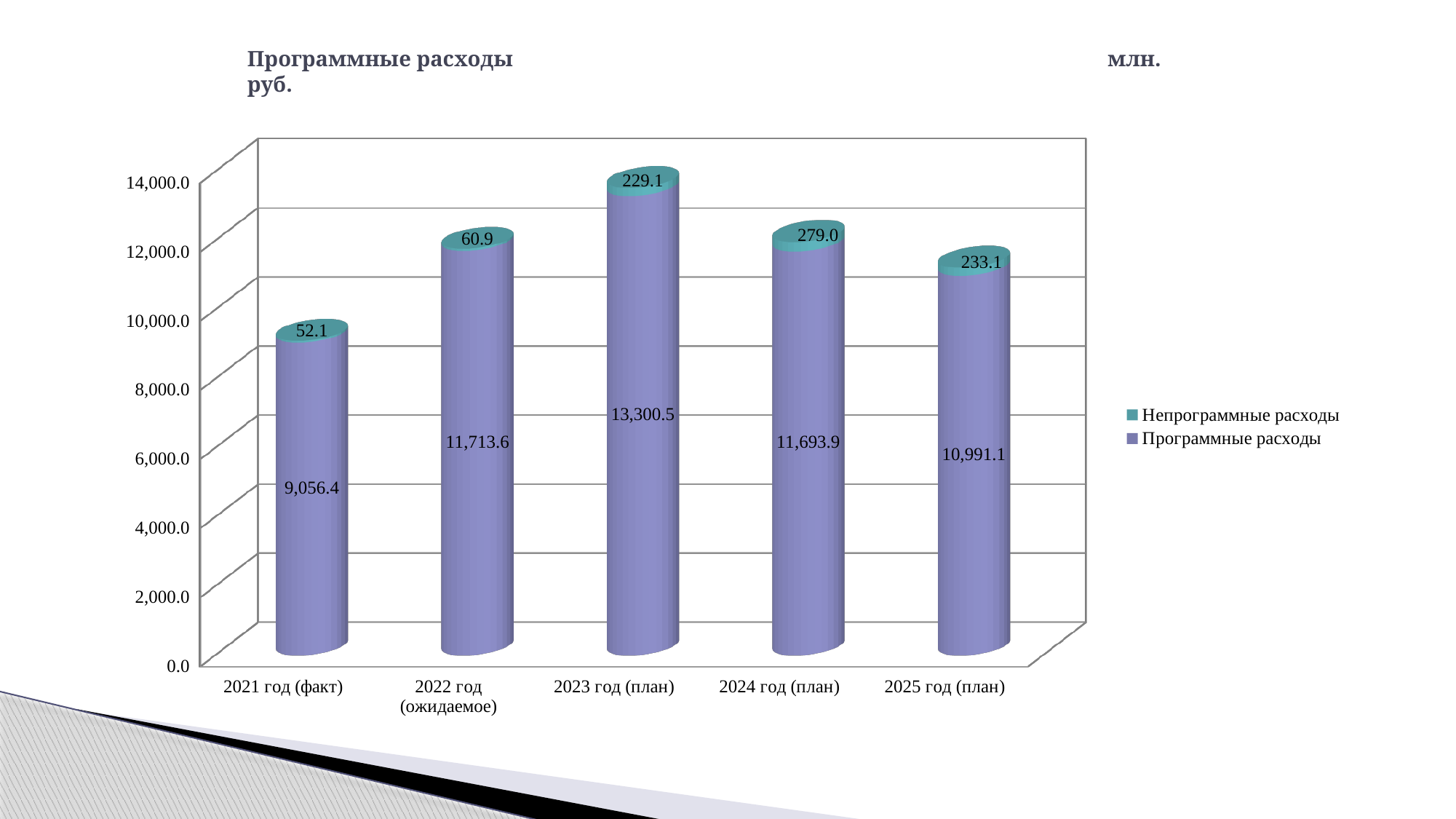
What kind of chart is shown on the slide? Stacked bar chart Which is larger: Программные расходы for 2024 год (план) or for 2025 год (план)? 2024 год (план) How many series does the legend list? 2 Which category has the highest value of Программные расходы? 2023 год (план) Which category has the lowest value of Непрограммные расходы? 2021 год (факт) What is the value of Программные расходы for 2023 год (план)? 13,300.5 What is the value of Программные расходы for 2021 год (факт)? 9,056.4 What is the total of the stacked bar for 2021 год (факт)? 9,108.5 What is the value of Непрограммные расходы for 2024 год (план)? 279.0 Which series is shown in teal in the legend? Непрограммные расходы What is the difference between Программные расходы for 2023 год (план) and 2022 год (ожидаемое)? 1,586.9 How many categories are shown on the x axis? 5